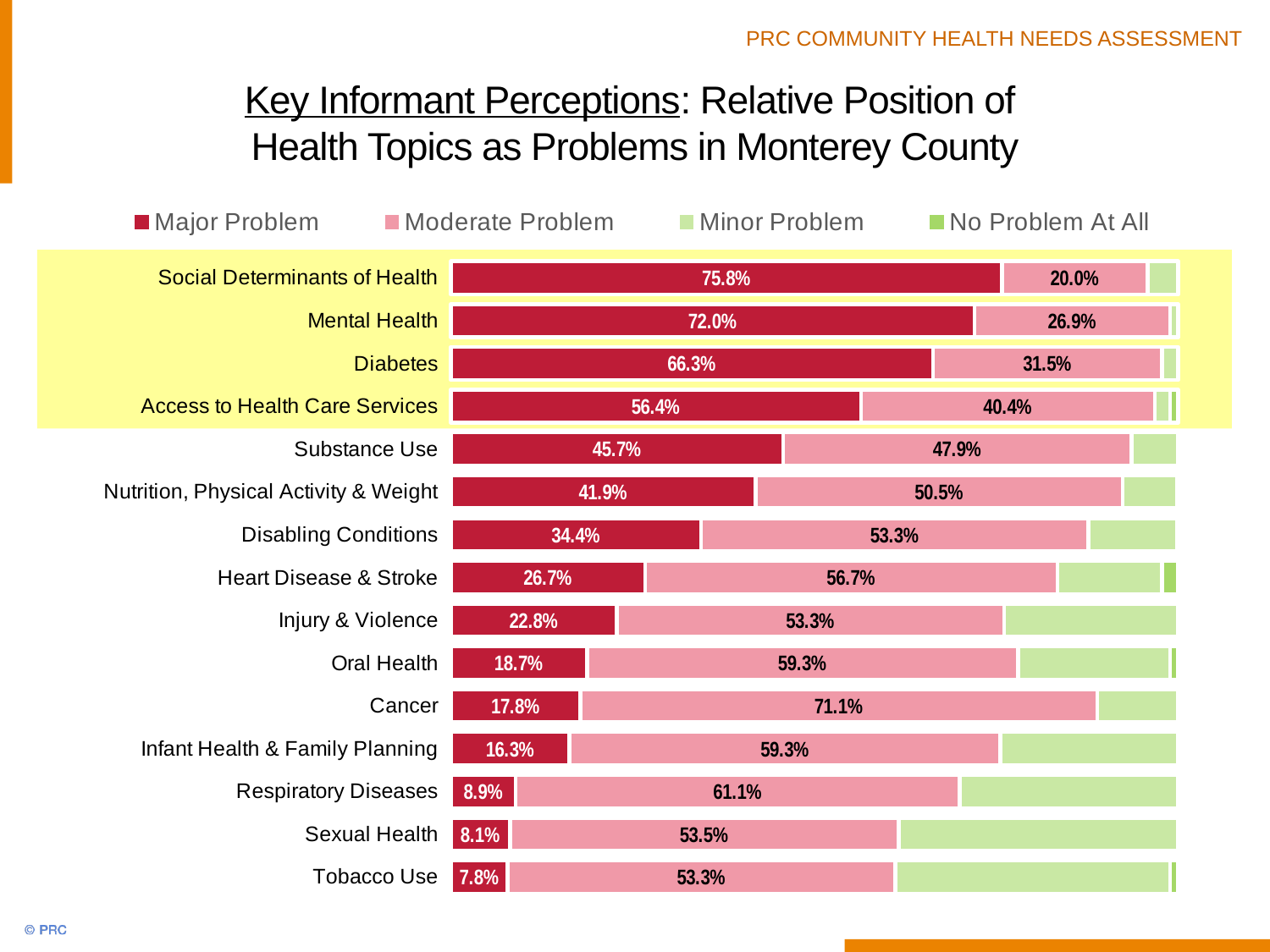
How many series does the legend list? 4 What percentage of key informants rated Social Determinants of Health as a Major Problem? 75.8% Which legend entry is shown in dark red? Major Problem What kind of chart is shown on the slide? Stacked bar chart Which health topic has the lowest Major Problem percentage? Tobacco Use How many health topics are shown in the chart? 15 What is the Major Problem value for Heart Disease & Stroke? 26.7% Which health topic has the highest Major Problem percentage? Social Determinants of Health Which has a larger Major Problem percentage, Diabetes or Access to Health Care Services? Diabetes Which health topic has the highest Moderate Problem percentage? Cancer What is the Moderate Problem value for Cancer? 71.1% What is the difference between the Major Problem and Moderate Problem percentages for Mental Health? 45.1%